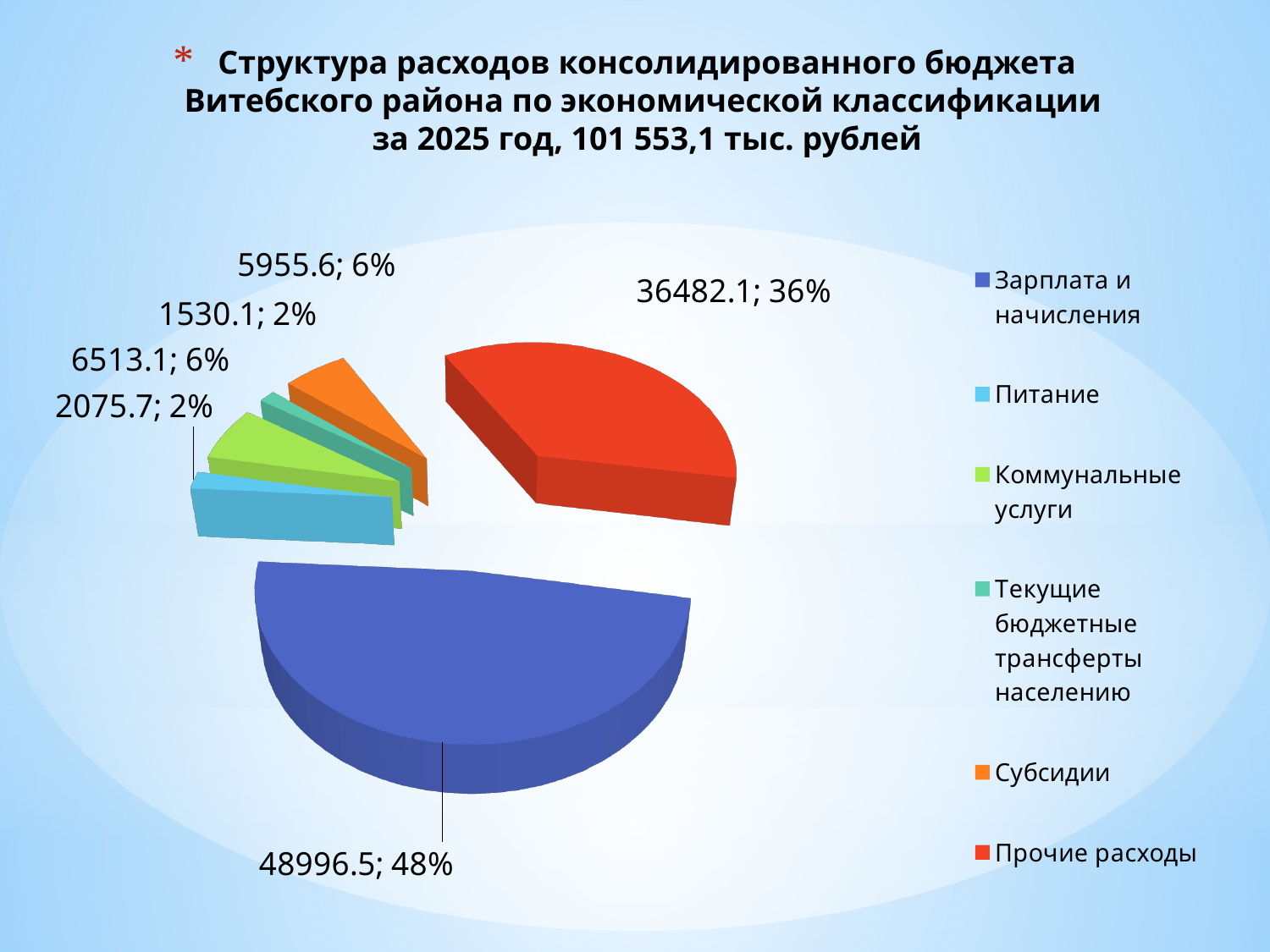
How many entries does the legend list? 6 What kind of chart is shown on the slide? pie chart Which category has the largest share of the pie? Зарплата и начисления What is the value for Прочие расходы? 36482.1 What is the value for Зарплата и начисления? 48996.5 Which category has the smallest value? Текущие бюджетные трансферты населению How many slices does the pie chart have? 6 Which is larger, Питание or Коммунальные услуги? Коммунальные услуги What is the value for Субсидии? 5955.6 What is the difference between the values for Зарплата и начисления and Прочие расходы? 12514.4 What is the value for Коммунальные услуги? 6513.1 What share of the pie does Прочие расходы represent? 36%